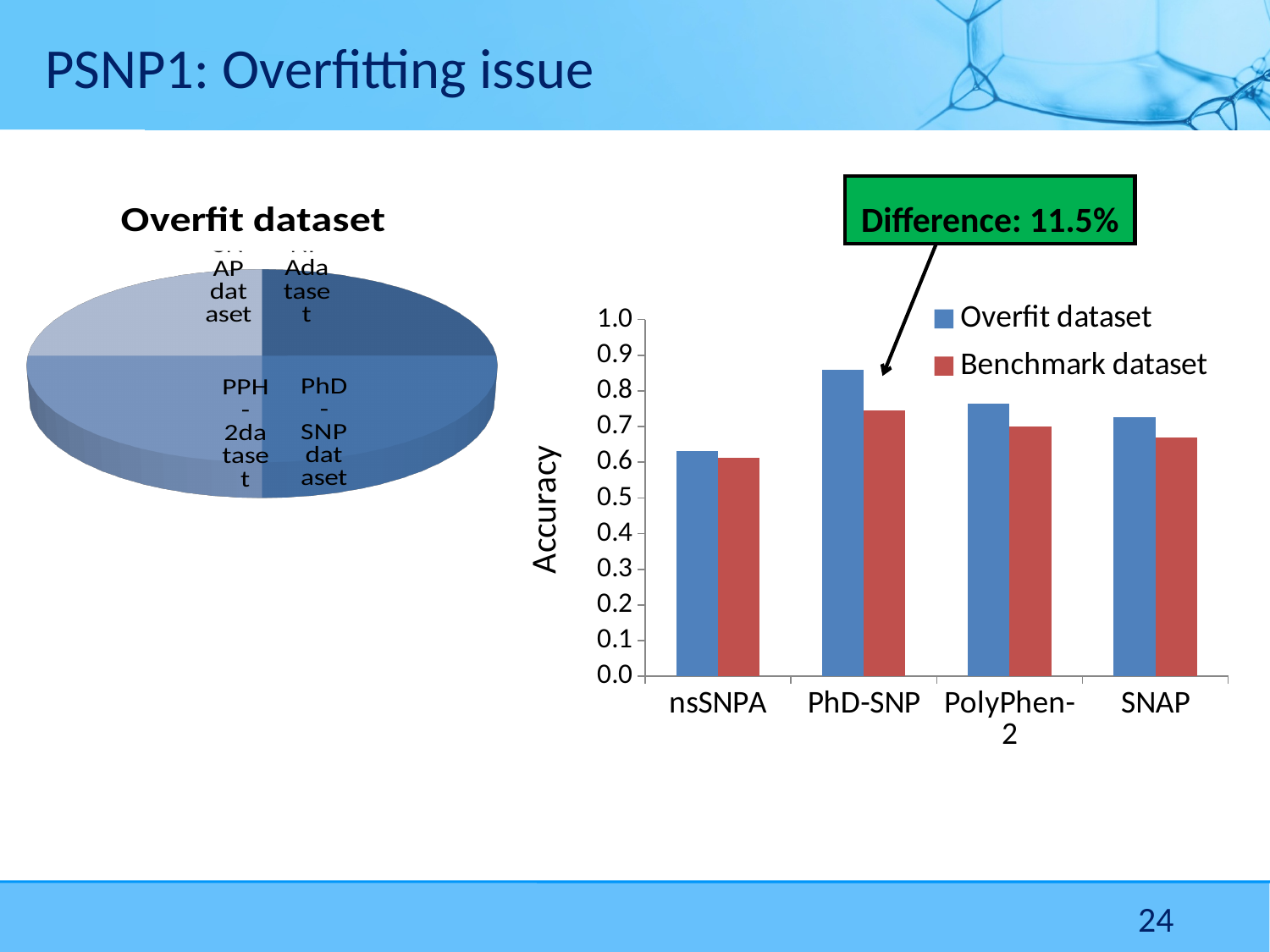
In the bar chart on the right, what is the label on the y axis? Accuracy In the bar chart on the right, is the Overfit dataset accuracy for nsSNPA greater or less than 0.7? less In the bar chart on the right, how many series does the legend list? 2 In the bar chart on the right, which category has the highest Overfit dataset accuracy? PhD-SNP What difference is annotated in the green box pointing to the PhD-SNP bars in the bar chart? 11.5% What kind of chart is the chart titled "Overfit dataset" on the left of the slide? pie chart In the bar chart on the right, is the Benchmark dataset accuracy for PhD-SNP greater or less than 0.7? greater In the bar chart on the right, is the Overfit dataset accuracy for PhD-SNP greater or less than 0.8? greater In the bar chart on the right, for PhD-SNP, which is larger: the Overfit dataset accuracy or the Benchmark dataset accuracy? Overfit dataset In the bar chart on the right, how many categories are shown on the x axis? 4 In the bar chart on the right, which category has the lowest Benchmark dataset accuracy? nsSNPA What kind of chart is the chart on the right of the slide? bar chart